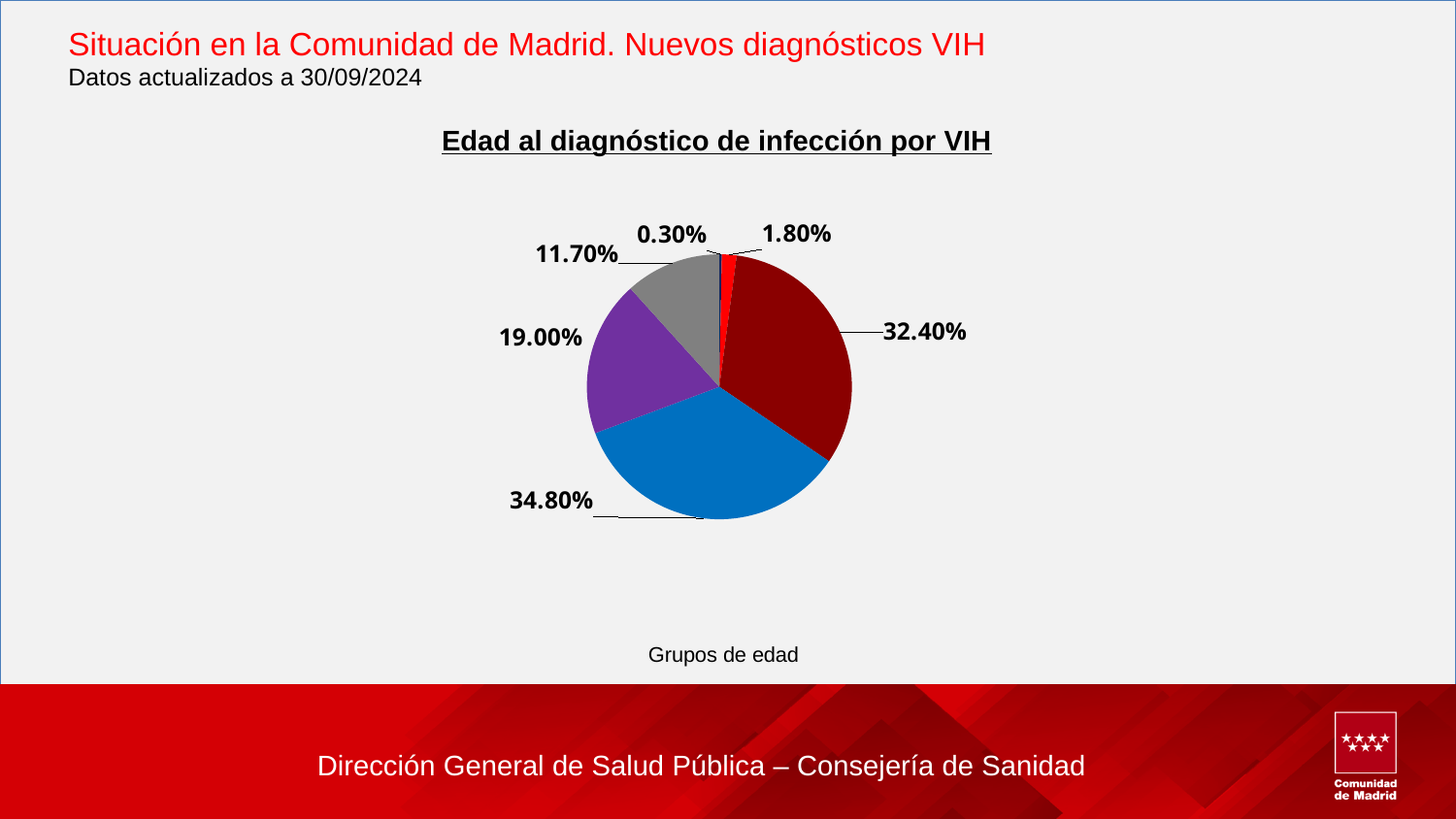
Which is larger, the dark red slice or the blue slice? the blue slice What is the value of the largest slice in the pie chart? 34.80% What is the value of the smallest slice in the pie chart? 0.30% What colour is the largest slice of the pie chart? blue How many slices does the pie chart have? 6 What is the difference between the two largest slices, 34.80% and 32.40%? 2.40% What is the title of the pie chart? Edad al diagnóstico de infección por VIH What kind of chart is shown on the slide? pie chart What percentage is shown for the purple slice of the pie chart? 19.00% What is the difference between the 19.00% slice and the 11.70% slice? 7.30% What percentage is shown for the gray slice of the pie chart? 11.70% What is the total of all the slice percentages shown in the pie chart? 100.00%